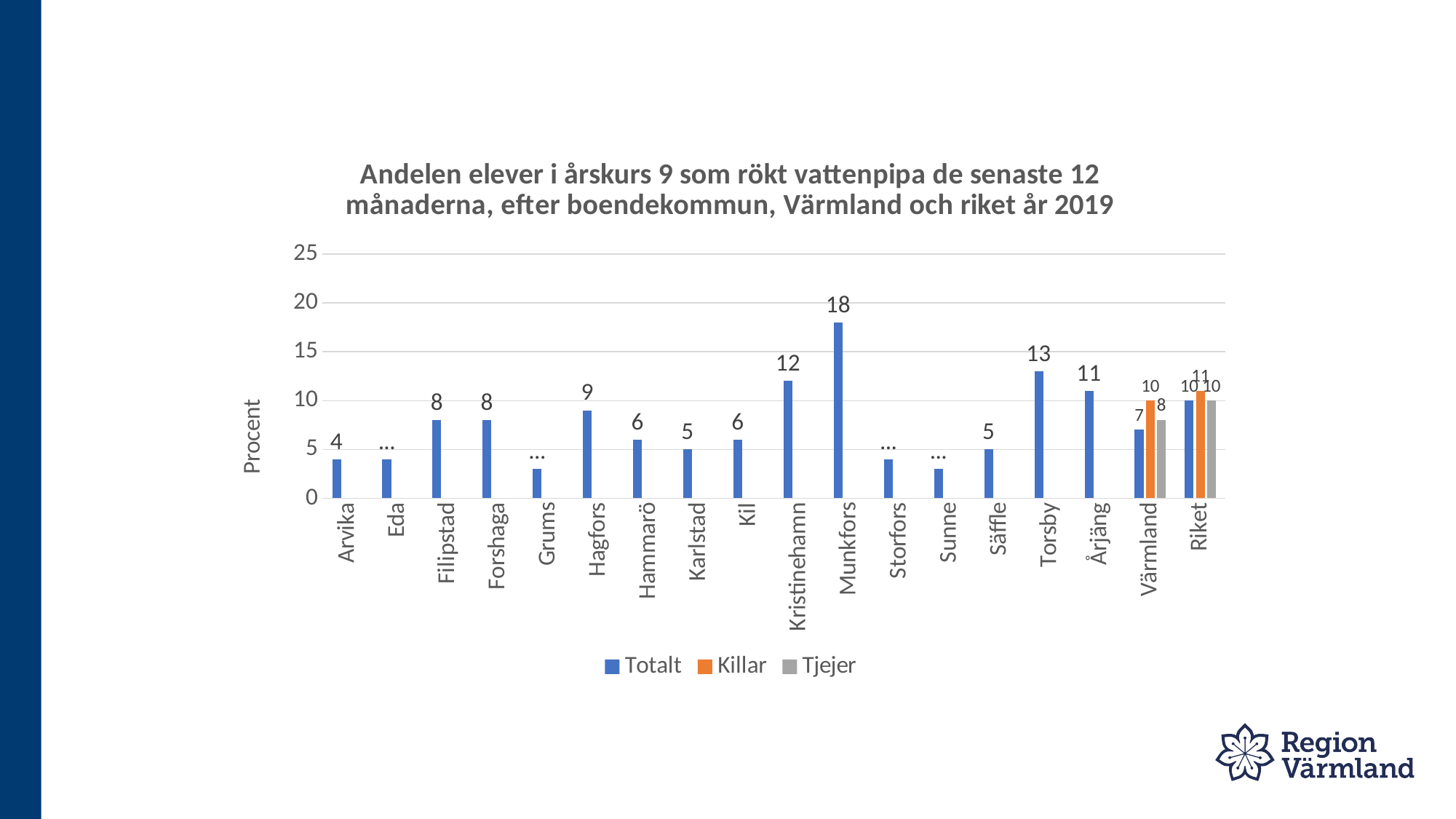
What kind of chart is shown on the slide? Bar chart What is the Totalt value for Kristinehamn? 12 How many categories are shown on the x axis? 18 What is the label on the y axis? Procent What is the Tjejer value for Riket? 10 Is the Totalt value for Grums greater or less than 5? less Which municipality has the highest Totalt value? Munkfors How many series does the legend list? 3 What is the Totalt value for Munkfors? 18 What is the Killar value for Värmland? 10 What is the difference between the Totalt values for Torsby and Årjäng? 2 Which has a higher Totalt value, Hagfors or Hammarö? Hagfors